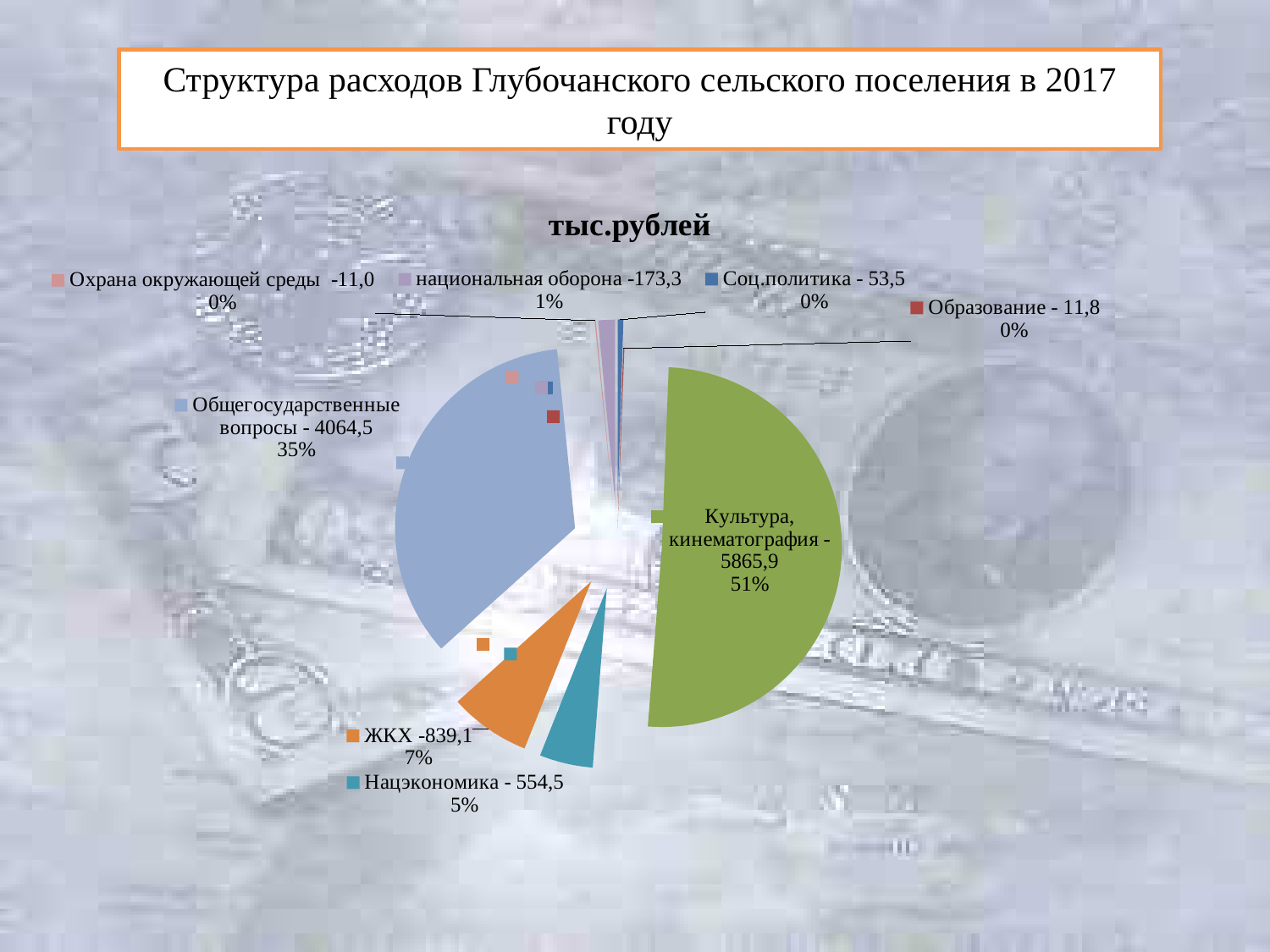
What share of the pie does Общегосударственные вопросы take? 35% Which is larger, the value for ЖКХ or the value for Нацэкономика? ЖКХ What kind of chart is shown on the slide? pie chart Which category has the largest slice of the pie? Культура, кинематография What is the difference between the values for Культура, кинематография and Общегосударственные вопросы? 1801,4 Which category has the smallest value? Охрана окружающей среды What is the title of the chart? тыс.рублей What is the value for Нацэкономика? 554,5 What share of the pie does Культура, кинематография take? 51% What is the value for ЖКХ? 839,1 How many categories (slices) does the pie chart have? 8 What is the value for национальная оборона? 173,3